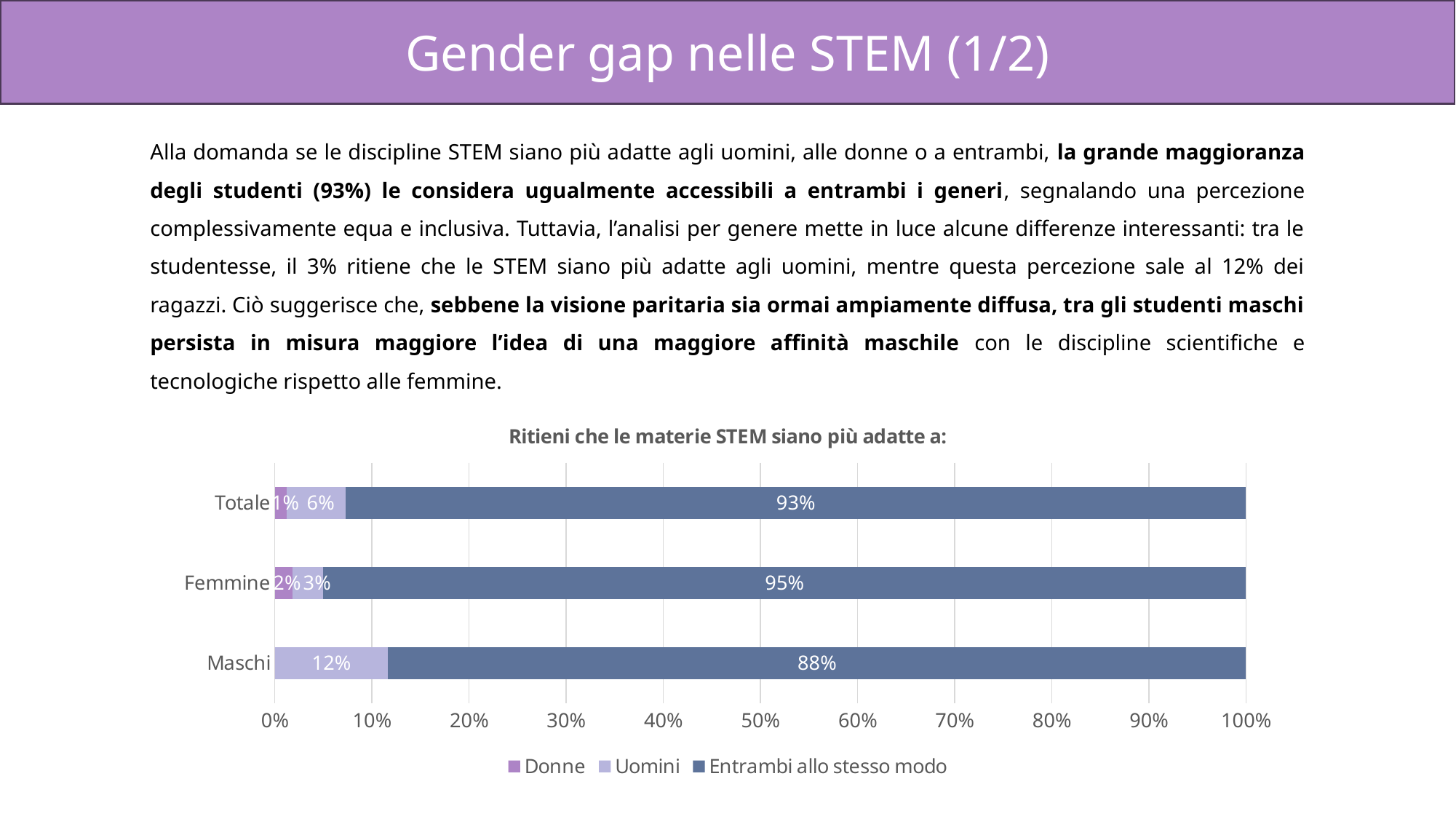
What kind of chart is shown on the slide? Stacked bar chart What is the value for 'Uomini' in the Maschi bar? 12% What percentage of Maschi answered 'Entrambi allo stesso modo'? 88% What is the title of the chart? Ritieni che le materie STEM siano più adatte a: What is the difference between the 'Uomini' value for Maschi and for Femmine? 9% Which category has the highest value for 'Entrambi allo stesso modo'? Femmine Which category has the lowest value for 'Entrambi allo stesso modo'? Maschi What percentage of Femmine answered 'Uomini'? 3% How many series does the legend list? 3 Which is larger: the 'Entrambi allo stesso modo' value for Totale or for Maschi? Totale What is the value for 'Donne' in the Totale bar? 1% How many categories are shown on the vertical axis? 3